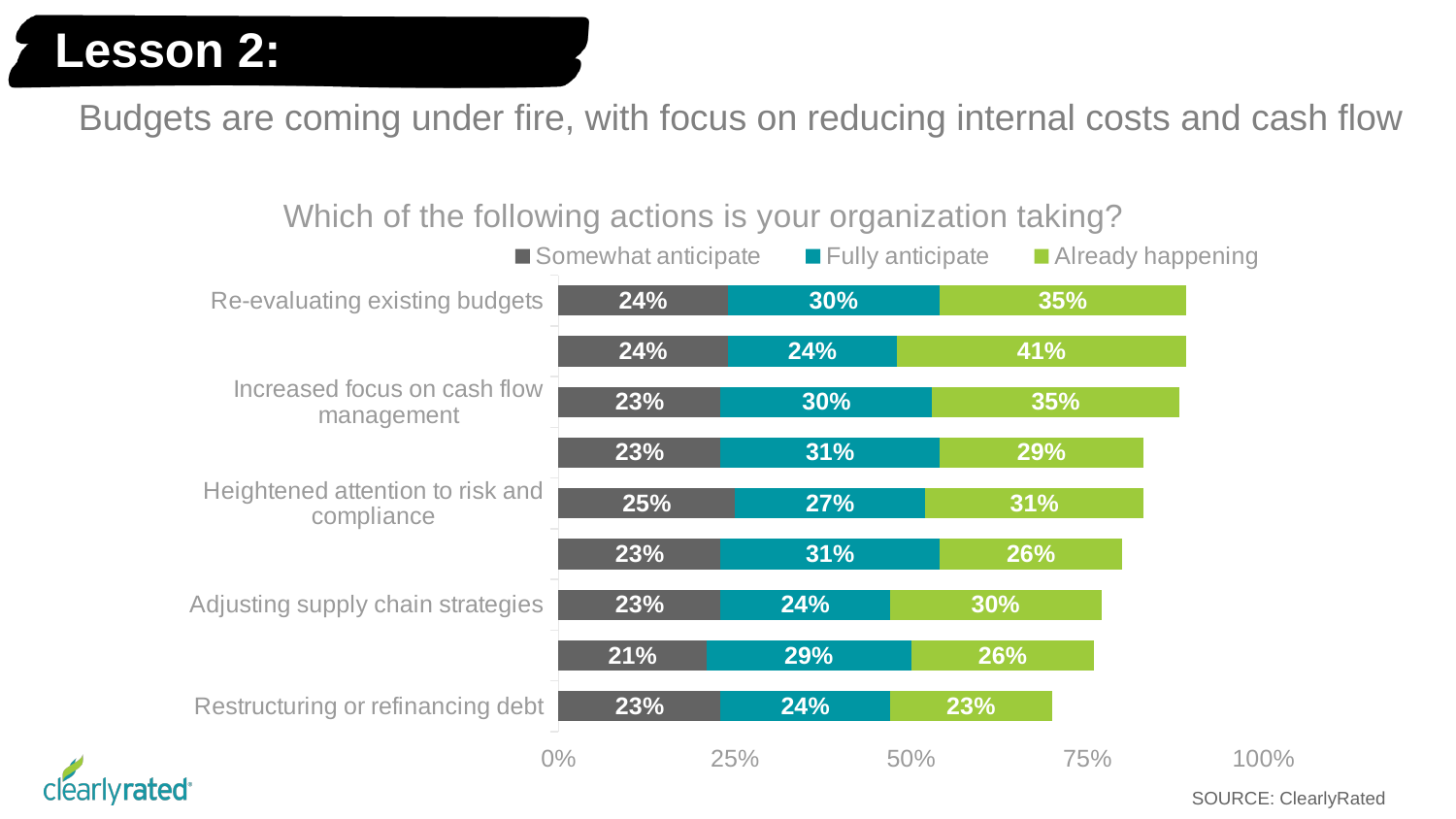
What is the total of the stacked bar for 'Re-evaluating existing budgets'? 89% What is the total of the stacked bar for 'Restructuring or refinancing debt'? 70% Which is larger: the 'Fully anticipate' value for 'Re-evaluating existing budgets' or for 'Adjusting supply chain strategies'? Re-evaluating existing budgets What is the difference between the 'Already happening' values for 'Increased focus on cash flow management' and 'Restructuring or refinancing debt'? 12% What is the title of the chart? Which of the following actions is your organization taking? What is the 'Already happening' value for 'Re-evaluating existing budgets'? 35% How many series does the legend list? 3 What is the 'Already happening' value for 'Adjusting supply chain strategies'? 30% What is the 'Fully anticipate' value for 'Heightened attention to risk and compliance'? 27% What kind of chart is shown on the slide? Stacked bar chart How many bars are plotted in the chart? 9 What is the 'Somewhat anticipate' value for 'Restructuring or refinancing debt'? 23%